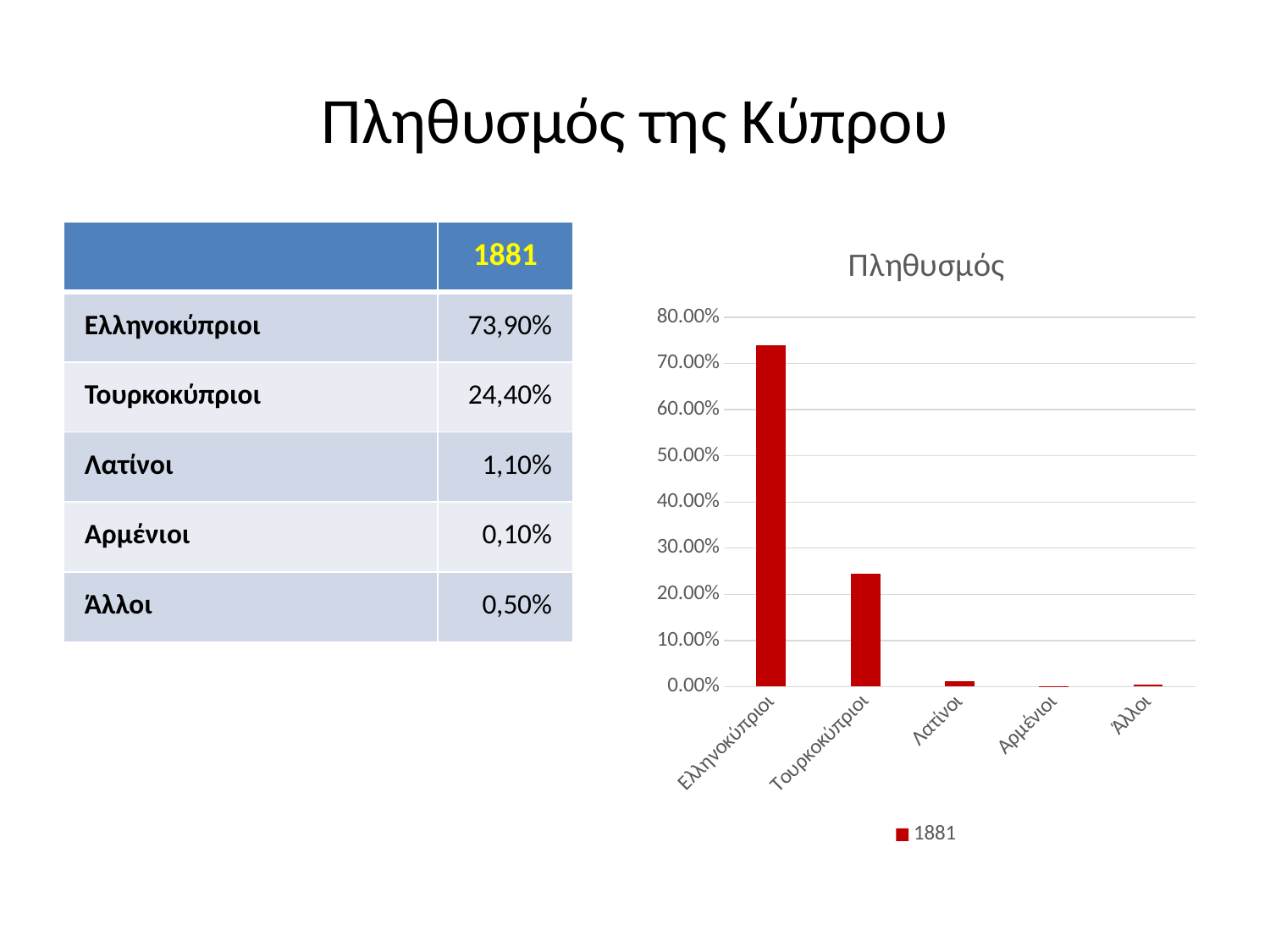
What is the legend entry for the series in the chart? 1881 How many categories are shown on the x axis of the chart? 5 What type of chart is shown on the slide? bar chart What is the difference between the values for Ελληνοκύπριοι and Τουρκοκύπριοι? 49,50% What is the value for Ελληνοκύπριοι in 1881? 73,90% Is the value for Τουρκοκύπριοι greater or less than 30.00%? less Which is larger, the value for Λατίνοι or the value for Τουρκοκύπριοι? Τουρκοκύπριοι How many series does the chart legend list? 1 Which category has the highest value in the chart? Ελληνοκύπριοι What is the title of the chart? Πληθυσμός What is the value for Τουρκοκύπριοι in 1881? 24,40% Which category has the lowest value in the chart? Αρμένιοι